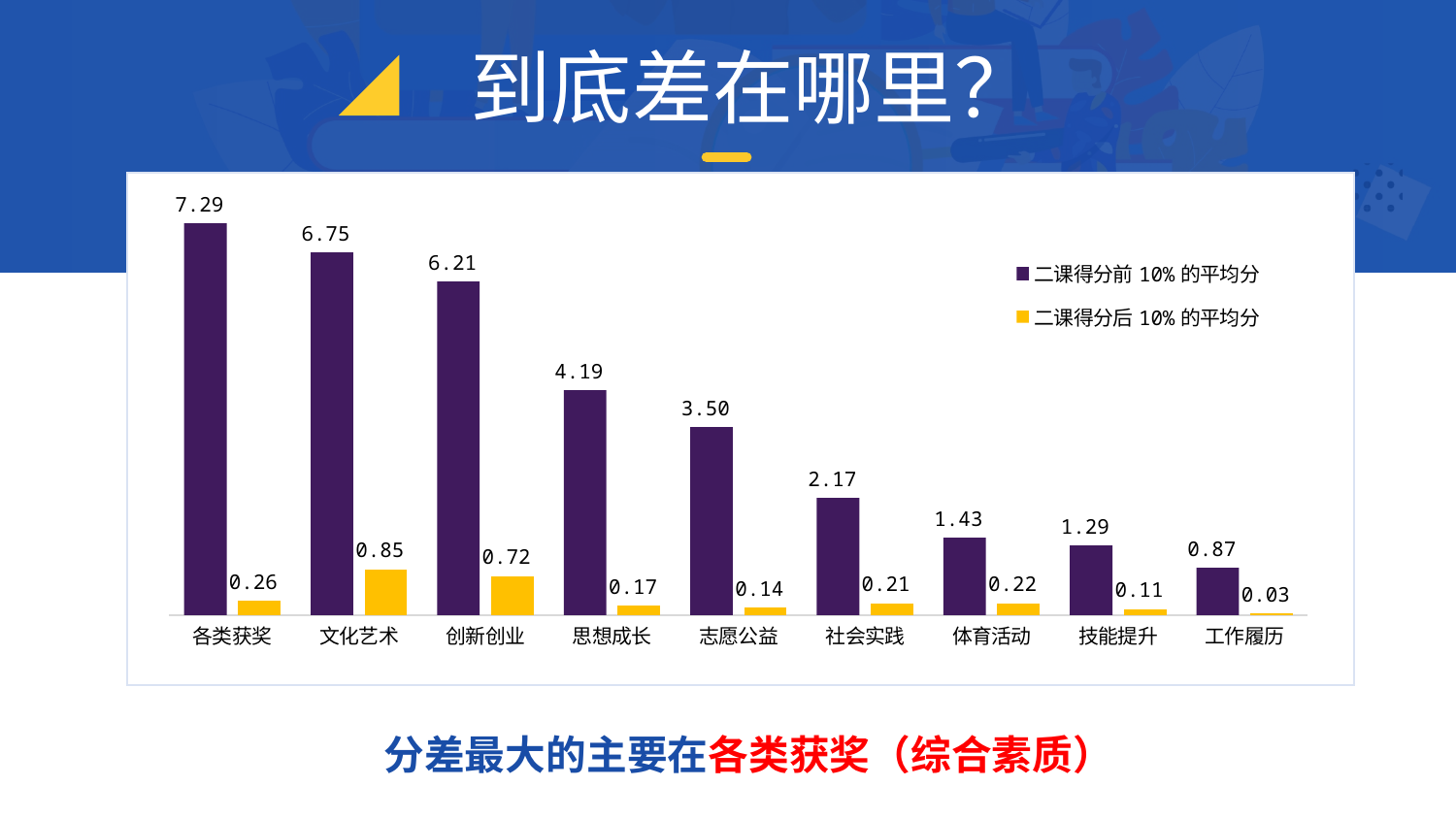
What is the value of 二课得分前 10% 的平均分 for 志愿公益? 3.50 What is the value of 二课得分后 10% 的平均分 for 文化艺术? 0.85 How many categories are shown on the x axis of the chart? 9 Do the values of 二课得分前 10% 的平均分 rise or fall from left to right along the x axis? Fall What is the difference between 二课得分前 10% 的平均分 and 二课得分后 10% 的平均分 for 各类获奖? 7.03 What kind of chart is shown on the slide? Bar chart Which category has the lowest value for 二课得分前 10% 的平均分? 工作履历 What is the value of 二课得分前 10% 的平均分 for 各类获奖? 7.29 How many series does the chart's legend list? 2 Which category has the highest value for 二课得分后 10% 的平均分? 文化艺术 Which is larger: 二课得分后 10% 的平均分 for 社会实践 or for 体育活动? 体育活动 Which colour represents 二课得分后 10% 的平均分 in the chart? Yellow